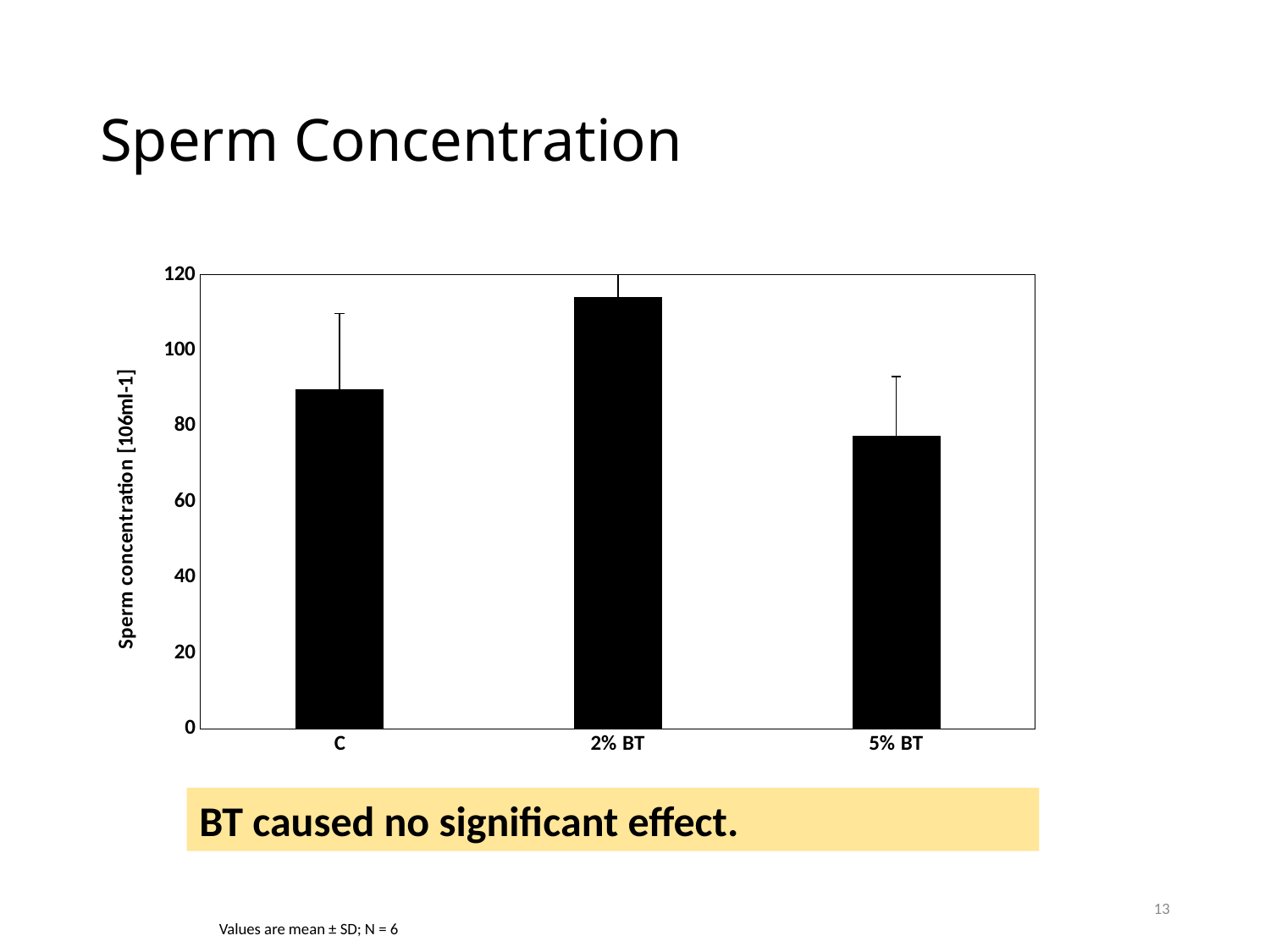
Is the value for 5% BT greater or less than 60? greater Is the value for 2% BT greater or less than 100? greater Which category has the highest sperm concentration? 2% BT Which has a larger sperm concentration, C or 2% BT? 2% BT What is the label of the y axis of the chart? Sperm concentration [106ml-1] What kind of chart is shown on the slide? bar chart Is the value for C greater or less than 100? less How many categories are shown on the x axis of the chart? 3 Does the sperm concentration rise or fall from 2% BT to 5% BT? fall Which has a larger sperm concentration, C or 5% BT? C Which category has the lowest sperm concentration? 5% BT